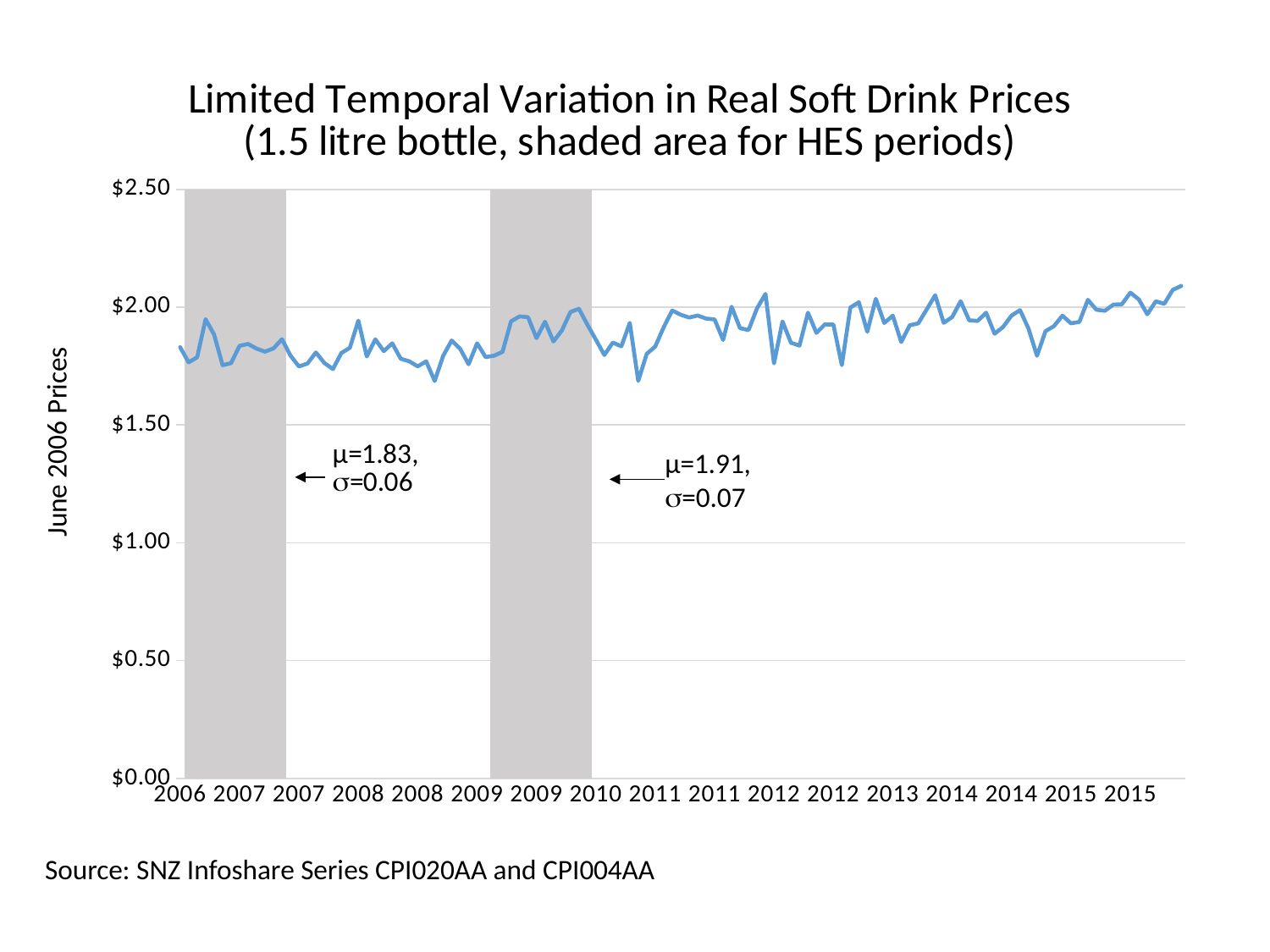
Which shaded HES period has the higher annotated mean price, the first or the second? The second What is the difference between the annotated mean prices of the second and first HES periods? 0.08 How many shaded HES periods are marked on the chart? 2 What is the mean (μ) price annotated for the first shaded HES period? 1.83 What is the standard deviation (σ) annotated for the second shaded HES period? 0.07 What is the title of the chart? Limited Temporal Variation in Real Soft Drink Prices (1.5 litre bottle, shaded area for HES periods) What is the label on the vertical axis? June 2006 Prices What kind of chart is shown on the slide? Line chart What is the mean (μ) price annotated for the second shaded HES period? 1.91 What is the standard deviation (σ) annotated for the first shaded HES period? 0.06 Is the real soft drink price at the end of 2015 greater or less than $2.50? less Is the real soft drink price at the start of 2006 greater or less than $1.50? greater